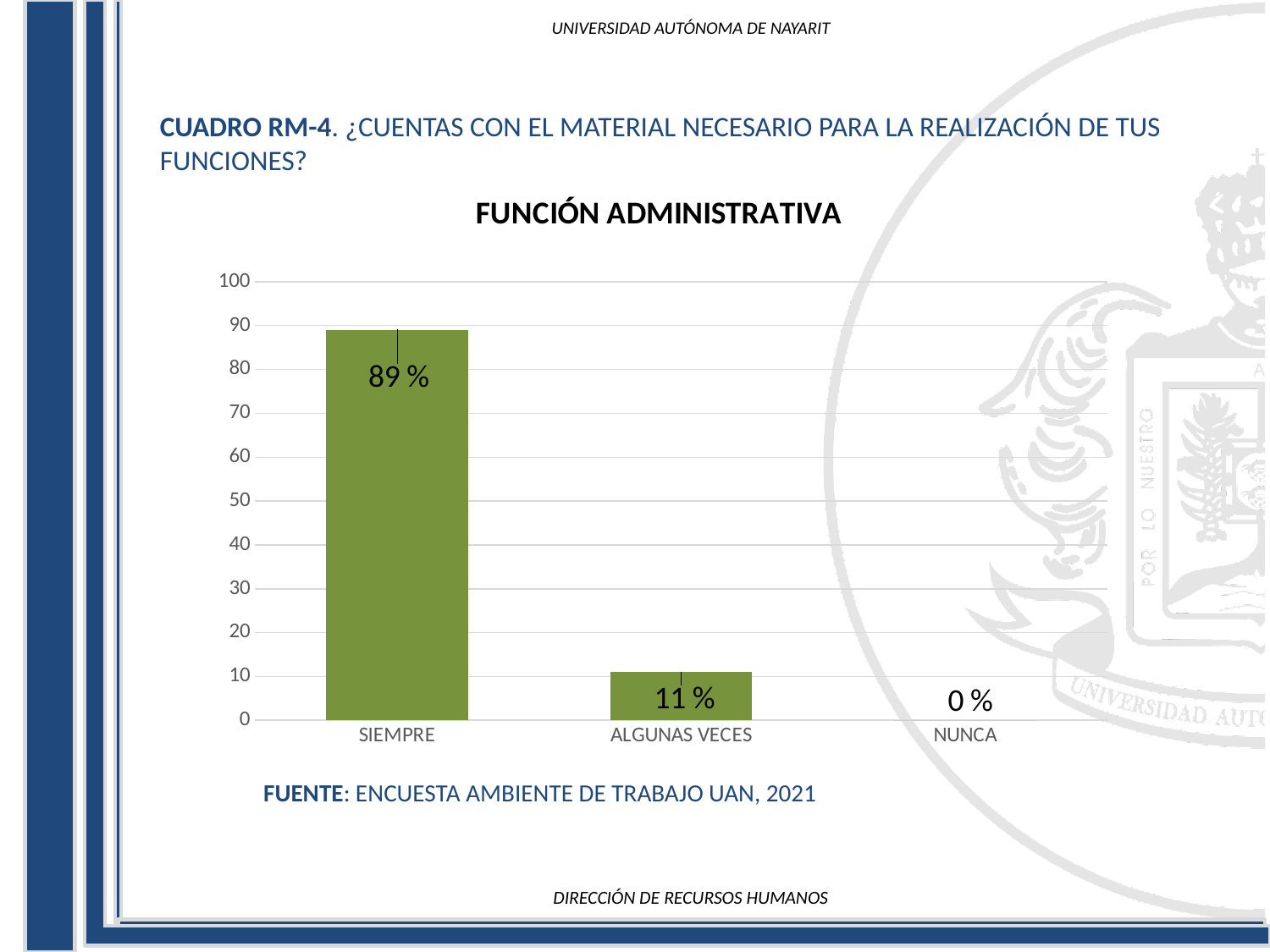
What is the title of the chart? FUNCIÓN ADMINISTRATIVA What is the difference between the values for SIEMPRE and ALGUNAS VECES? 78 % Is the value for SIEMPRE greater or less than 80? greater What is the value for NUNCA? 0 % Which category has the lowest value? NUNCA Which category has the highest value? SIEMPRE How many categories are shown on the x axis? 3 What kind of chart is shown on the slide? bar chart What is the value for SIEMPRE? 89 % Which is larger, the value for ALGUNAS VECES or the value for NUNCA? ALGUNAS VECES What is the value for ALGUNAS VECES? 11 % Do the values rise or fall from left to right along the x axis? fall